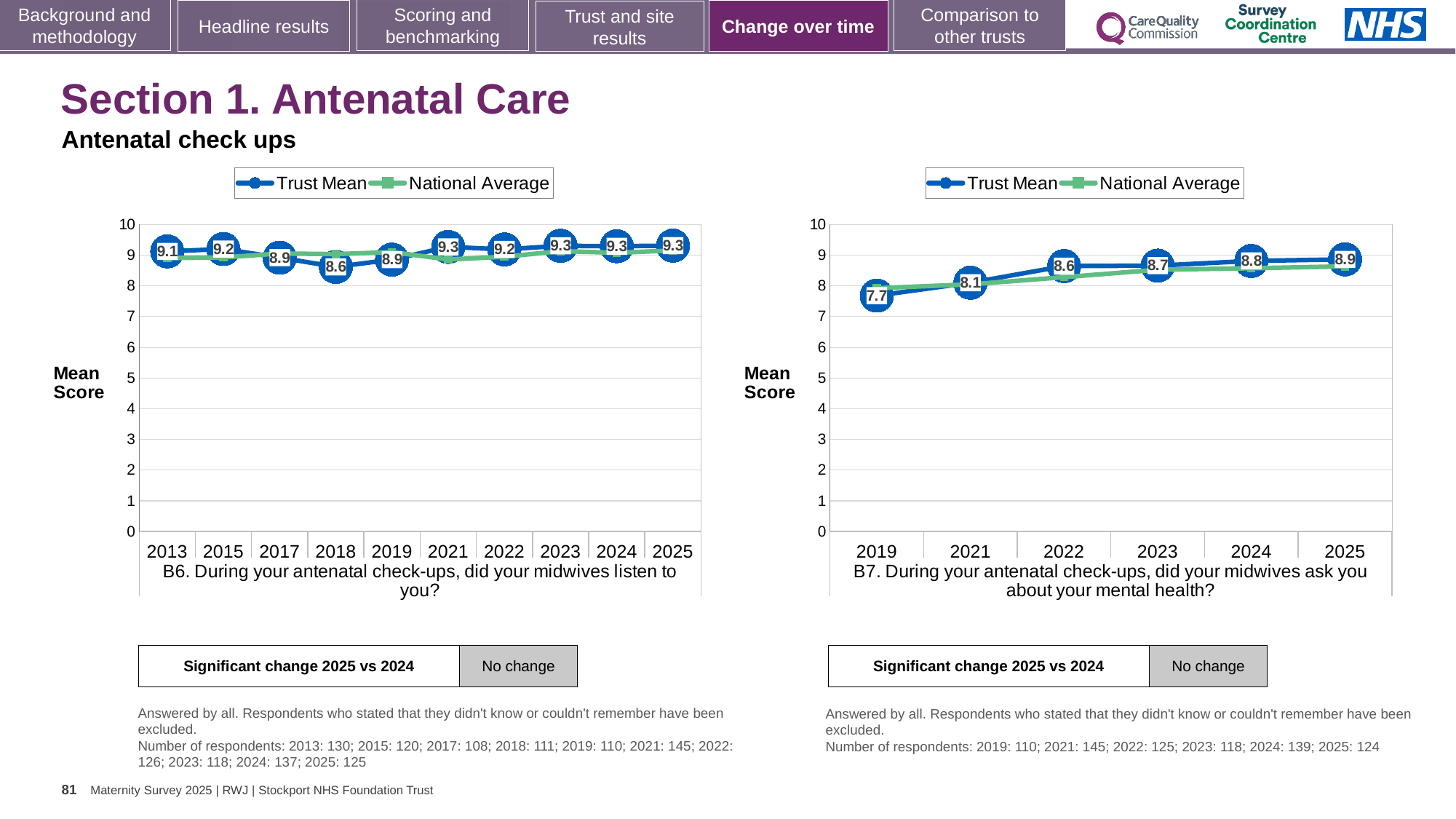
In the B7 chart on the right, what is the difference between the Trust Mean for 2025 and the Trust Mean for 2019? 1.2 How many years are plotted in the B6 chart on the left? 10 How many series does the legend of the B7 chart on the right list? 2 In the B6 chart on the left, is the National Average for 2018 greater or less than 8? greater In the B6 chart on the left, what is the Trust Mean for 2018? 8.6 In the B7 chart on the right, what is the Trust Mean for 2025? 8.9 In the B7 chart on the right, does the Trust Mean rise or fall from 2019 to 2025? rise In the B7 chart on the right, which year has the highest Trust Mean? 2025 In the B7 chart on the right, what is the Trust Mean for 2019? 7.7 In the B7 chart on the right, which year has the lowest Trust Mean? 2019 In the B6 chart on the left, which year has the lowest Trust Mean? 2018 In the B6 chart on the left, which is larger: the Trust Mean for 2018 or the Trust Mean for 2021? 2021